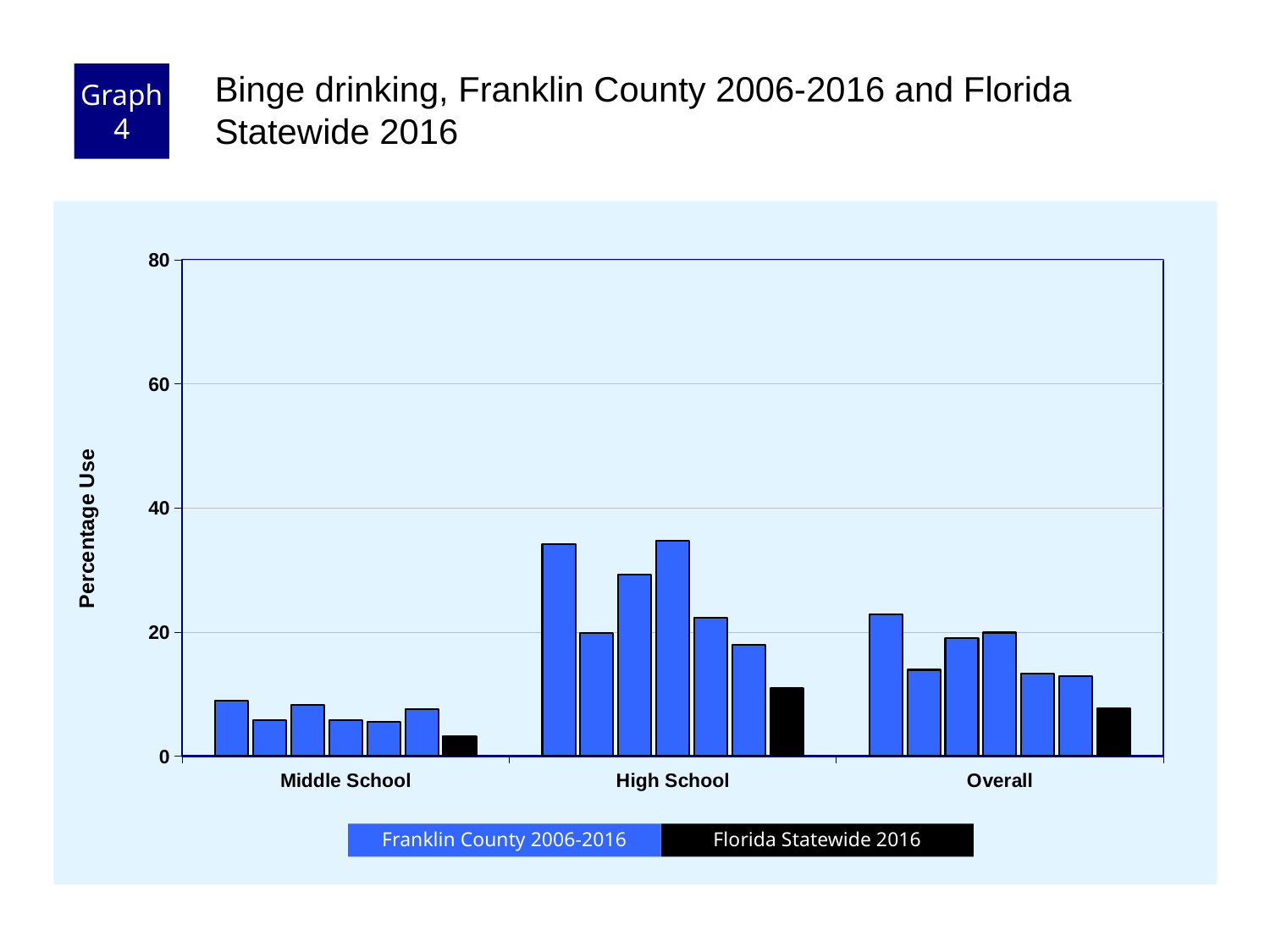
What kind of chart is shown on the slide? bar chart How many series does the legend list? 2 What is the label of the y axis? Percentage Use Which category has the lowest Florida Statewide 2016 value? Middle School Is the Florida Statewide 2016 value for Overall greater or less than 20? less Is the Florida Statewide 2016 value for High School greater or less than 20? less How many categories are shown on the x axis? 3 Which is larger, the Florida Statewide 2016 value for High School or for Middle School? High School Is the tallest Franklin County 2006-2016 bar for High School greater or less than 40? less Which category has the highest Florida Statewide 2016 value? High School Which colour represents Florida Statewide 2016 in the legend? black